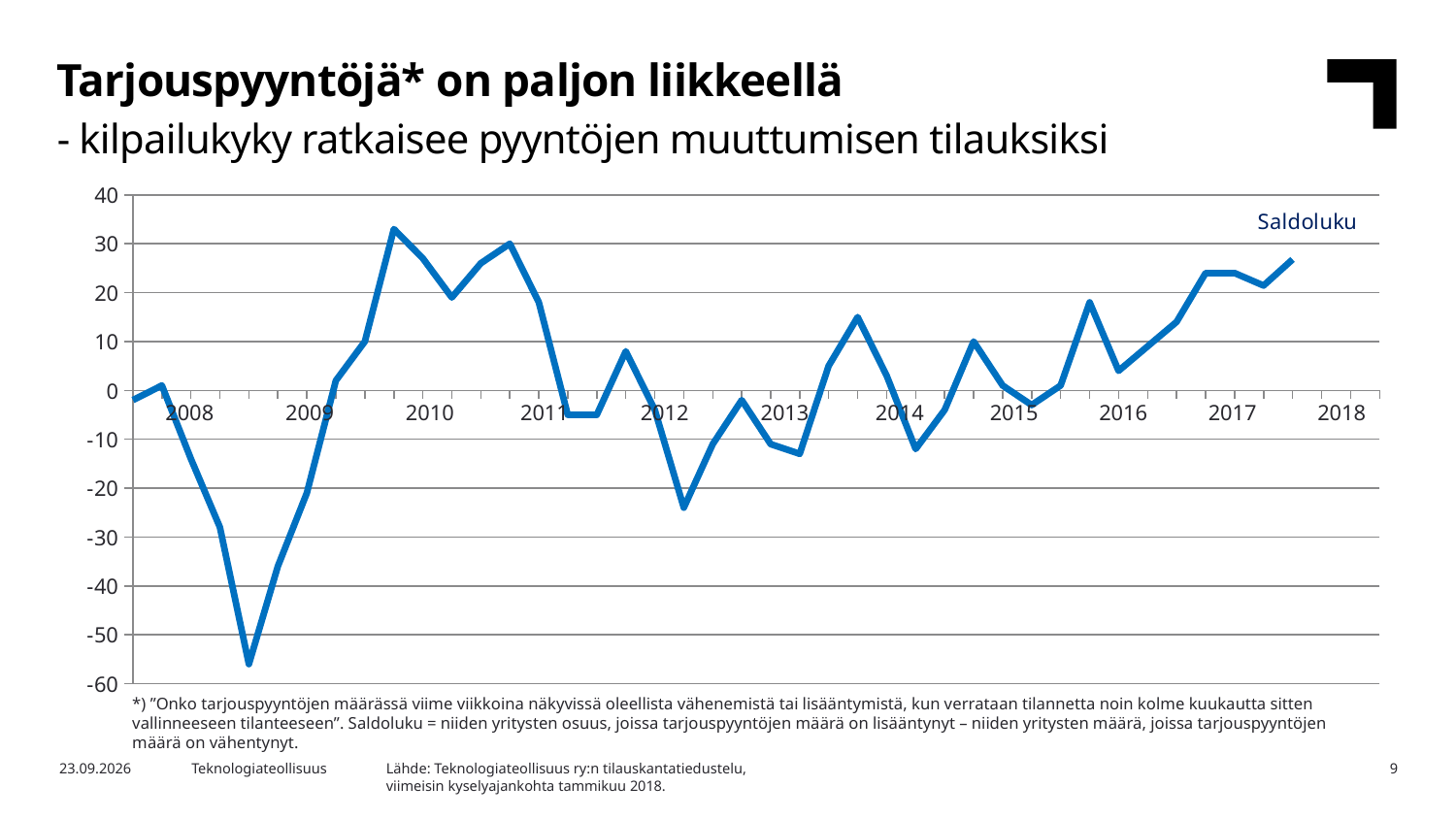
Is the highest value of the line greater or less than 30? greater How many years are labelled on the x axis of the chart? 11 What kind of chart is shown on the slide? line chart In which year does the line reach its lowest point? 2009 Does the line rise or fall between 2017 and 2018? rise Does the line rise or fall from the start of 2008 to the start of 2009? fall Is the lowest value of the line greater or less than -50? less Is the lowest value reached in 2012 greater or less than -20? less What is the name of the series shown in the chart? Saldoluku How many series does the chart show? 1 What is the highest value shown on the y axis of the chart? 40